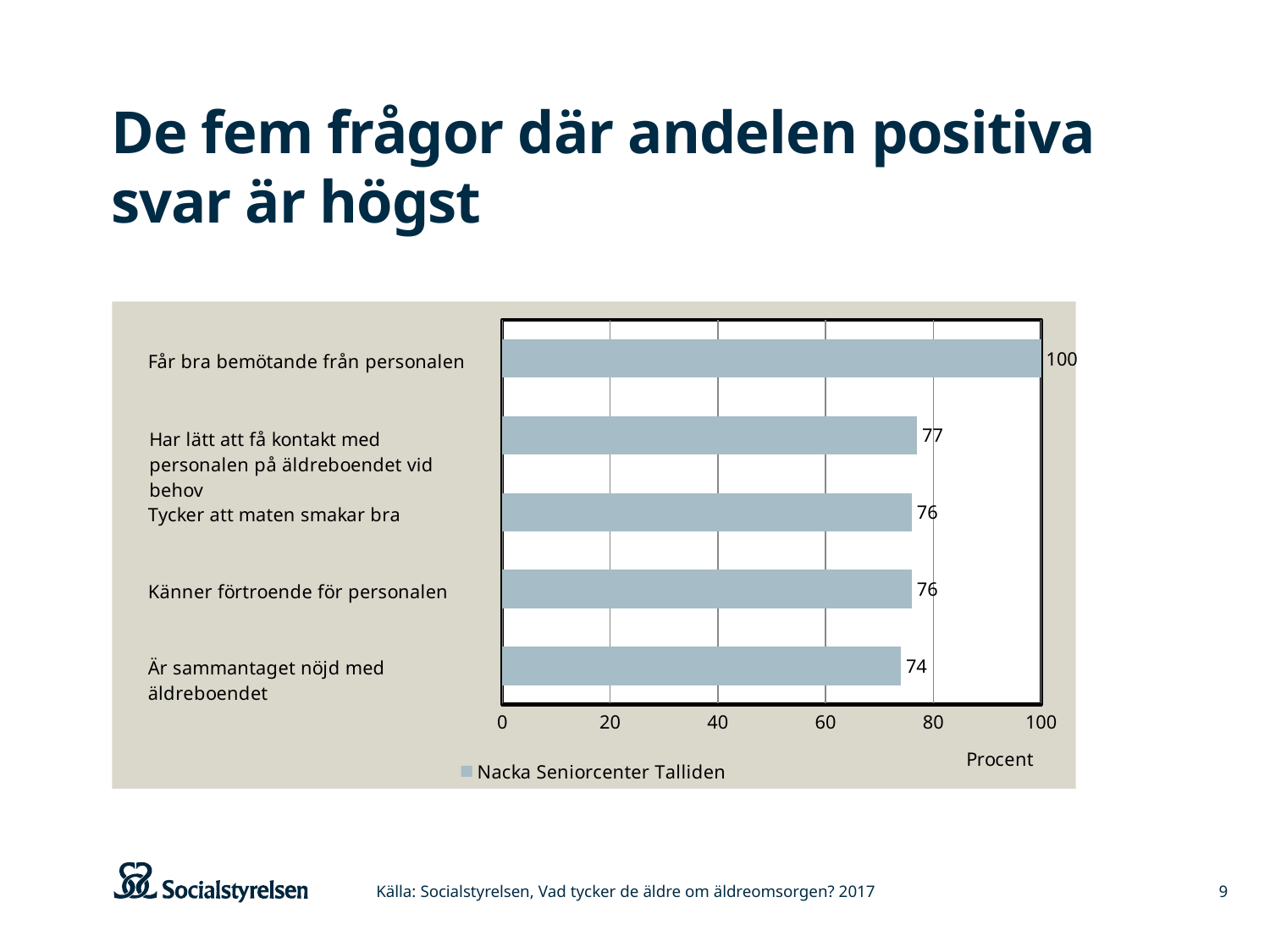
How many categories are shown in the chart? 5 What is the value for "Är sammantaget nöjd med äldreboendet"? 74 What kind of chart is shown on the slide? Bar chart What series name does the legend show? Nacka Seniorcenter Talliden Is the value for "Känner förtroende för personalen" greater or less than 60? greater What is the value for "Tycker att maten smakar bra"? 76 Which category has the highest value? Får bra bemötande från personalen What is the value for "Får bra bemötande från personalen"? 100 What is the difference between the values for "Får bra bemötande från personalen" and "Är sammantaget nöjd med äldreboendet"? 26 Which is larger: the value for "Har lätt att få kontakt med personalen på äldreboendet vid behov" or the value for "Är sammantaget nöjd med äldreboendet"? Har lätt att få kontakt med personalen på äldreboendet vid behov What is the value for "Har lätt att få kontakt med personalen på äldreboendet vid behov"? 77 Which category has the lowest value? Är sammantaget nöjd med äldreboendet